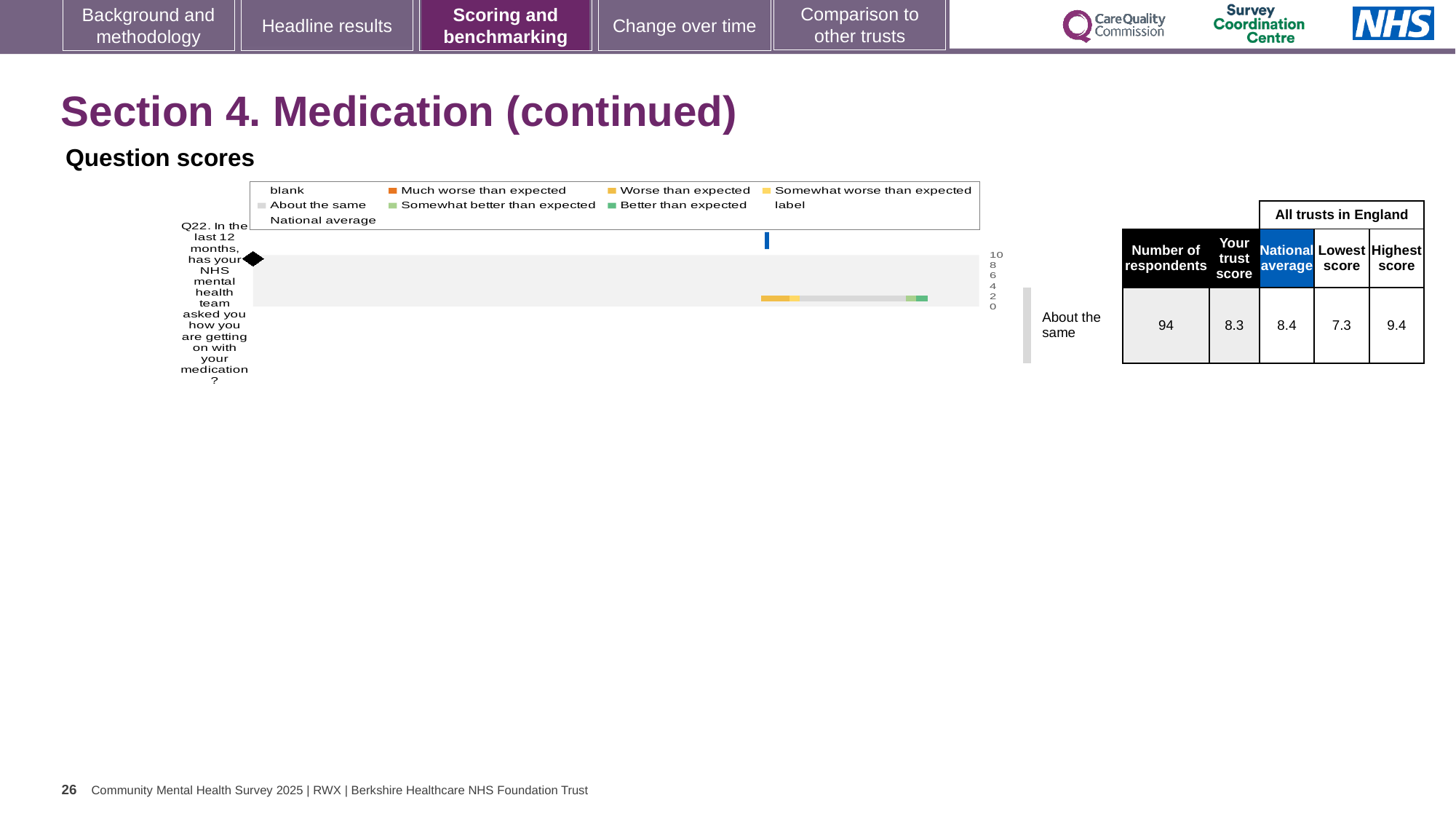
What is the 'Your trust score' value for Q22? 8.3 What kind of chart is shown under 'Question scores'? bar chart Which question number is plotted in the chart? Q22 What benchmark category is shown for Q22 next to the chart? About the same How many respondents answered Q22? 94 What is the difference between the Highest score and the Lowest score for Q22? 2.1 How many entries does the chart legend list? 9 How many survey questions are plotted in the chart? 1 Which is larger for Q22, the trust score or the National average? National average What is the Highest score among all trusts in England for Q22? 9.4 What is the National average score for Q22? 8.4 What is the Lowest score among all trusts in England for Q22? 7.3